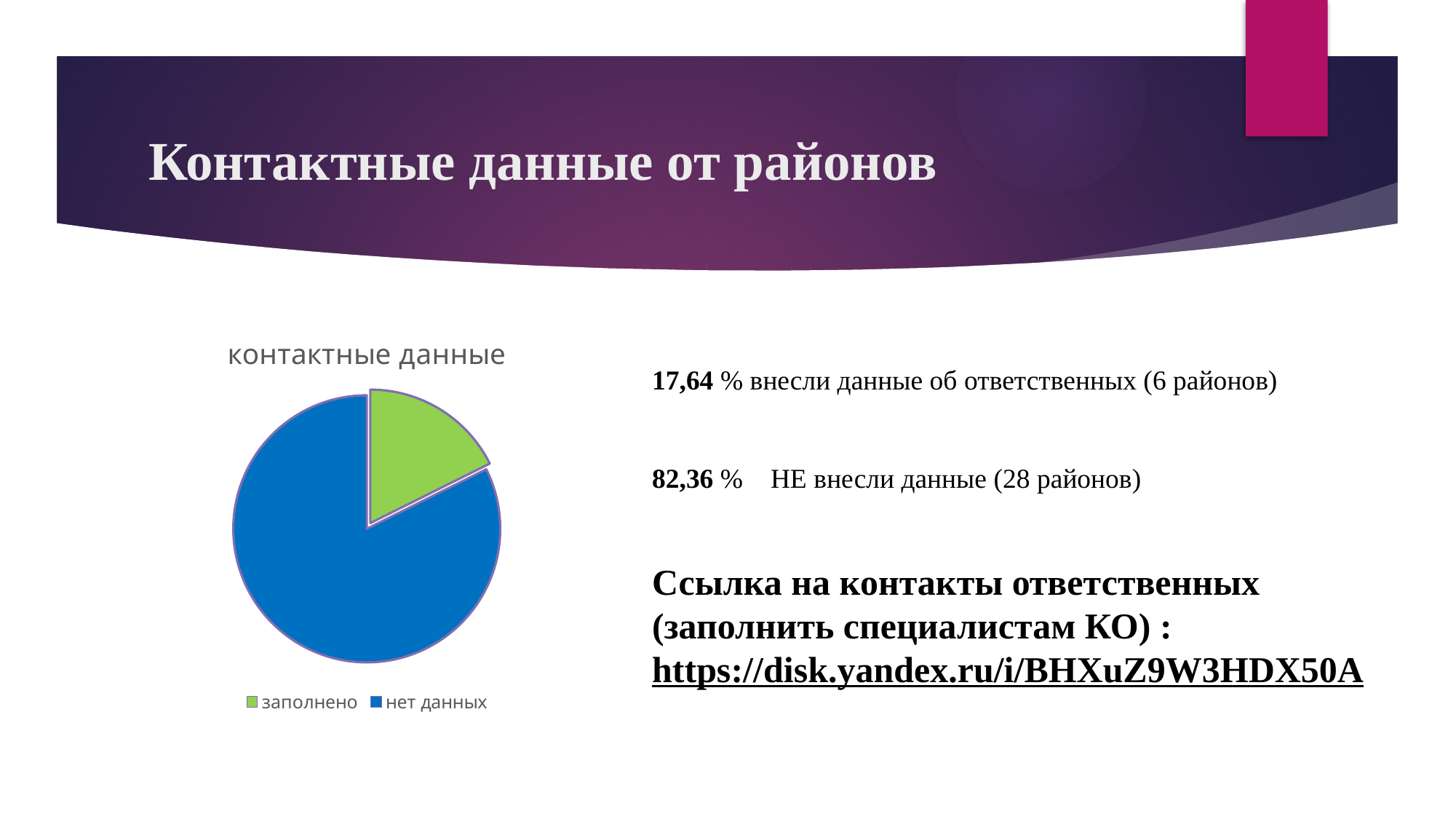
What colour is the заполнено slice in the pie chart? green How many slices does the pie chart have? 2 How many districts does the slide say entered contact data (заполнено)? 6 How many entries does the chart legend list? 2 Which category has the smallest slice in the pie chart? заполнено Which category has the largest slice in the pie chart? нет данных What is the title of the chart on the slide? контактные данные What kind of chart is shown on the slide? pie chart According to the slide, what share of districts is represented by the нет данных slice? 82,36 % Which slice is larger, заполнено or нет данных? нет данных According to the slide, what share of districts is represented by the заполнено slice? 17,64 % How many districts does the slide say did not enter data (нет данных)? 28